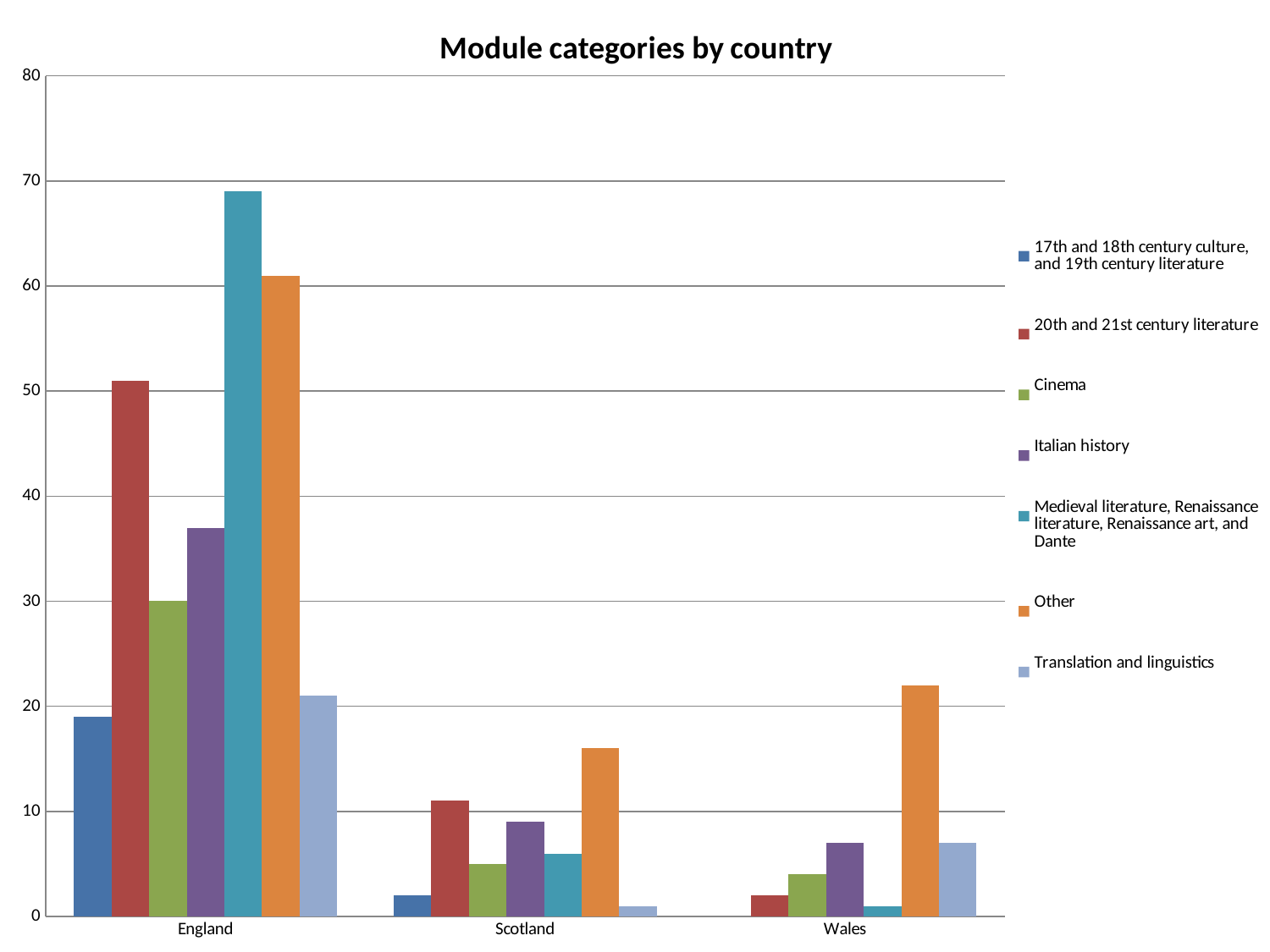
Is the value for Other in Scotland greater or less than 20? less Which series has the highest value for Wales? Other What type of chart is shown on the slide? bar chart How many countries are shown on the x axis? 3 How many series does the legend list? 7 Which country has the highest value for Other? England Which is larger for England: 20th and 21st century literature or Italian history? 20th and 21st century literature Which series has the lowest value for Scotland? Translation and linguistics What is the value for Cinema in England? 30 Is the value for Medieval literature, Renaissance literature, Renaissance art, and Dante in England greater or less than 60? greater Which series has the highest value for England? Medieval literature, Renaissance literature, Renaissance art, and Dante What is the title of the chart? Module categories by country